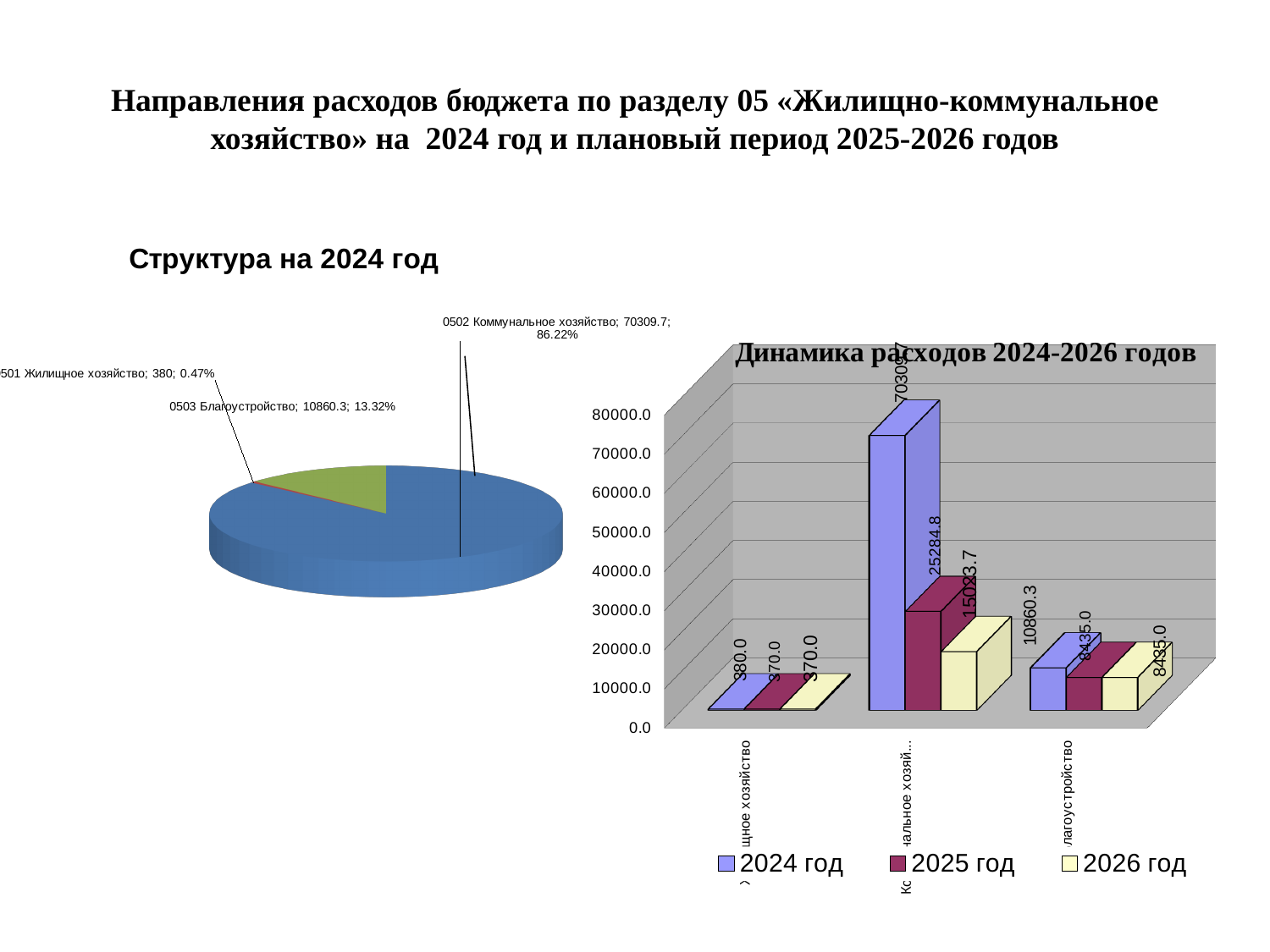
On the chart 'Динамика расходов 2024-2026 годов', what is the value for Коммунальное хозяйство in 2025 год? 25284.8 On the chart 'Динамика расходов 2024-2026 годов', is the 2024 год value for Коммунальное хозяйство greater or less than 60000.0? greater On the chart 'Динамика расходов 2024-2026 годов', how many series does the legend list? 3 On the pie chart 'Структура на 2024 год', what is the value for 0503 Благоустройство? 10860.3 On the pie chart 'Структура на 2024 год', which slice is the smallest? 0501 Жилищное хозяйство On the pie chart 'Структура на 2024 год', how many slices are there? 3 On the pie chart 'Структура на 2024 год', what share does 0503 Благоустройство have? 13.32% What kind of chart is 'Динамика расходов 2024-2026 годов'? bar chart On the pie chart 'Структура на 2024 год', what share does 0502 Коммунальное хозяйство have? 86.22% On the chart 'Динамика расходов 2024-2026 годов', what is the difference between the 2024 год and 2025 год values for Благоустройство? 2425.3 On the chart 'Динамика расходов 2024-2026 годов', what is the value for Благоустройство in 2026 год? 8435.0 On the chart 'Динамика расходов 2024-2026 годов', which is larger for Жилищное хозяйство: the 2024 год value or the 2025 год value? 2024 год